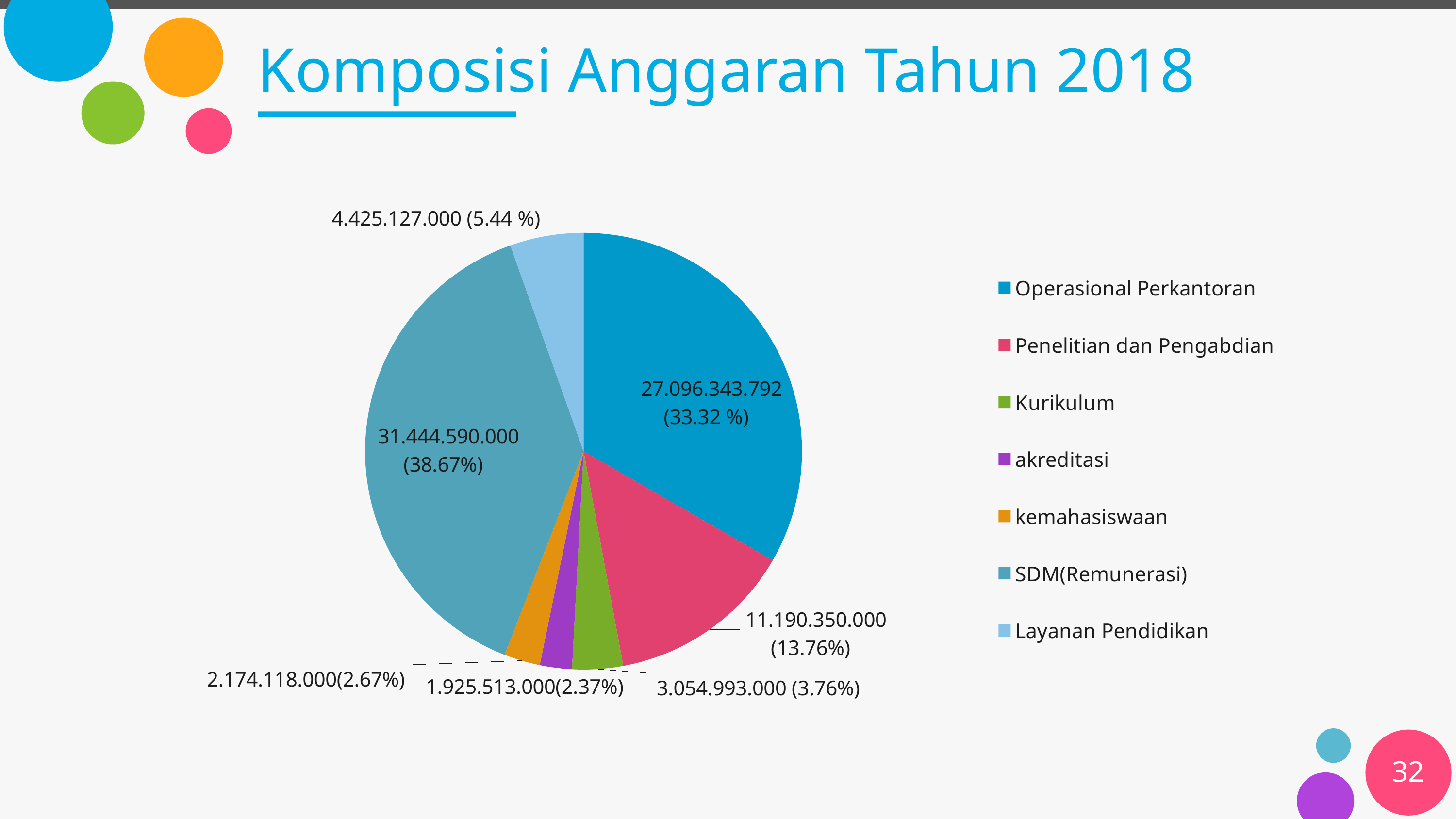
What value is shown for SDM(Remunerasi) in the pie chart? 31.444.590.000 What kind of chart is shown on the slide? pie chart What colour is the slice for Penelitian dan Pengabdian? pink What is the title of the chart on the slide? Komposisi Anggaran Tahun 2018 What percentage share does Operasional Perkantoran have in the pie chart? 33.32 % Which category has the smallest slice of the pie chart? akreditasi What percentage share does Layanan Pendidikan have in the pie chart? 5.44 % Which category has the largest slice of the pie chart? SDM(Remunerasi) How many categories does the legend of the pie chart list? 7 What value is shown for Penelitian dan Pengabdian? 11.190.350.000 Which is larger in the pie chart, Kurikulum or Layanan Pendidikan? Layanan Pendidikan What percentage share does kemahasiswaan have in the pie chart? 2.67%